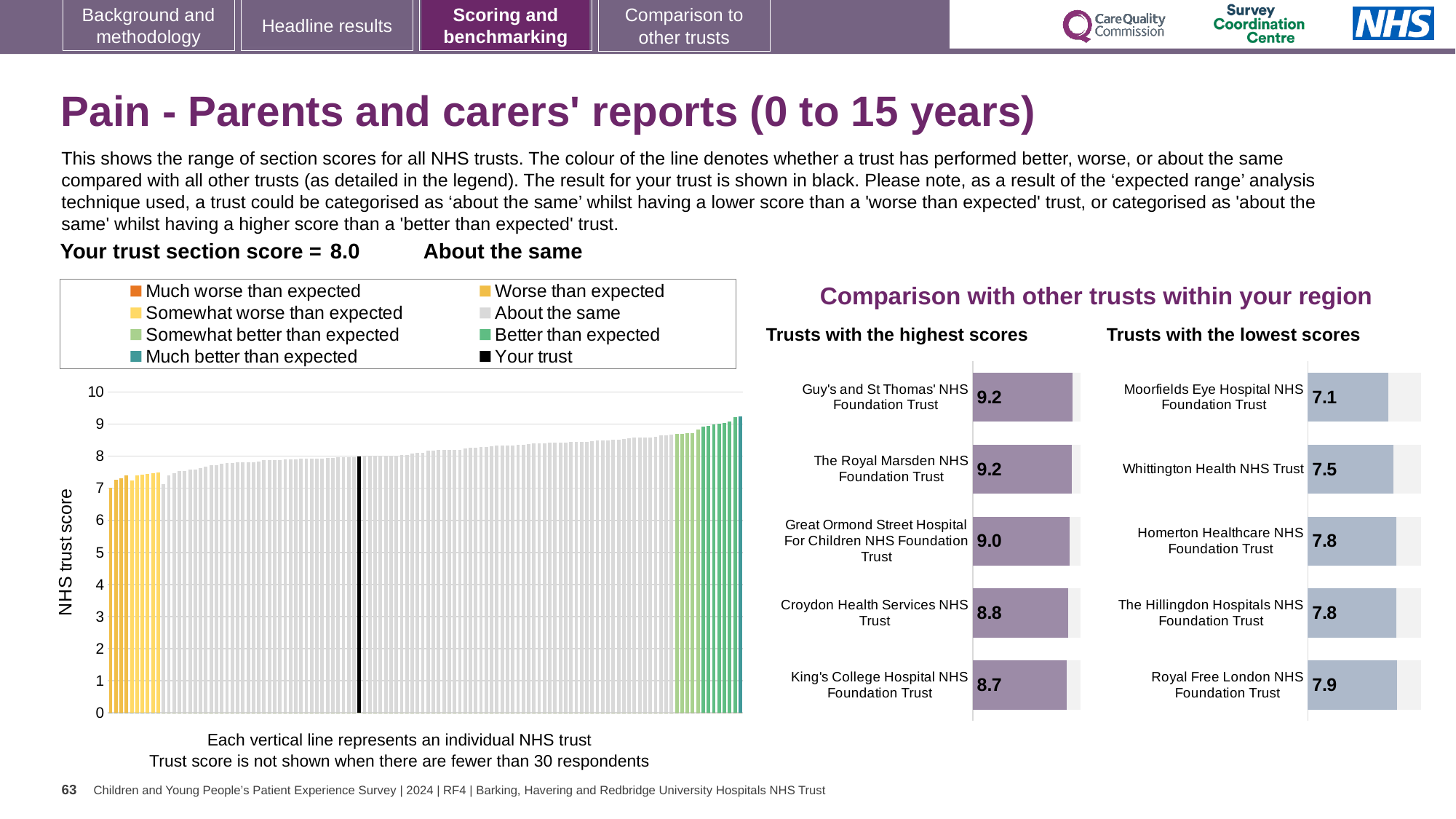
In the 'Trusts with the highest scores' chart, which trust has the lowest score? King's College Hospital NHS Foundation Trust In the 'Trusts with the highest scores' chart, what is the difference between the scores of Great Ormond Street Hospital For Children NHS Foundation Trust and King's College Hospital NHS Foundation Trust? 0.3 How many trusts are shown in the 'Trusts with the highest scores' chart? 5 In the 'Trusts with the lowest scores' chart, which has the higher score: Whittington Health NHS Trust or Homerton Healthcare NHS Foundation Trust? Homerton Healthcare NHS Foundation Trust In the 'Trusts with the lowest scores' chart, which trust has the highest score? Royal Free London NHS Foundation Trust In the 'Trusts with the lowest scores' chart, what is the difference between the scores of Royal Free London NHS Foundation Trust and Moorfields Eye Hospital NHS Foundation Trust? 0.8 In the main NHS trust score chart, is the value of the lowest (leftmost) bar greater or less than 8? less How many entries does the legend of the main NHS trust score chart list? 8 In the main NHS trust score chart, what is the section score for your trust (the black bar)? 8.0 What kind of chart is the main chart showing the NHS trust scores? Bar chart In the 'Trusts with the lowest scores' chart, what is the score for Moorfields Eye Hospital NHS Foundation Trust? 7.1 In the 'Trusts with the highest scores' chart, what is the score for Croydon Health Services NHS Trust? 8.8